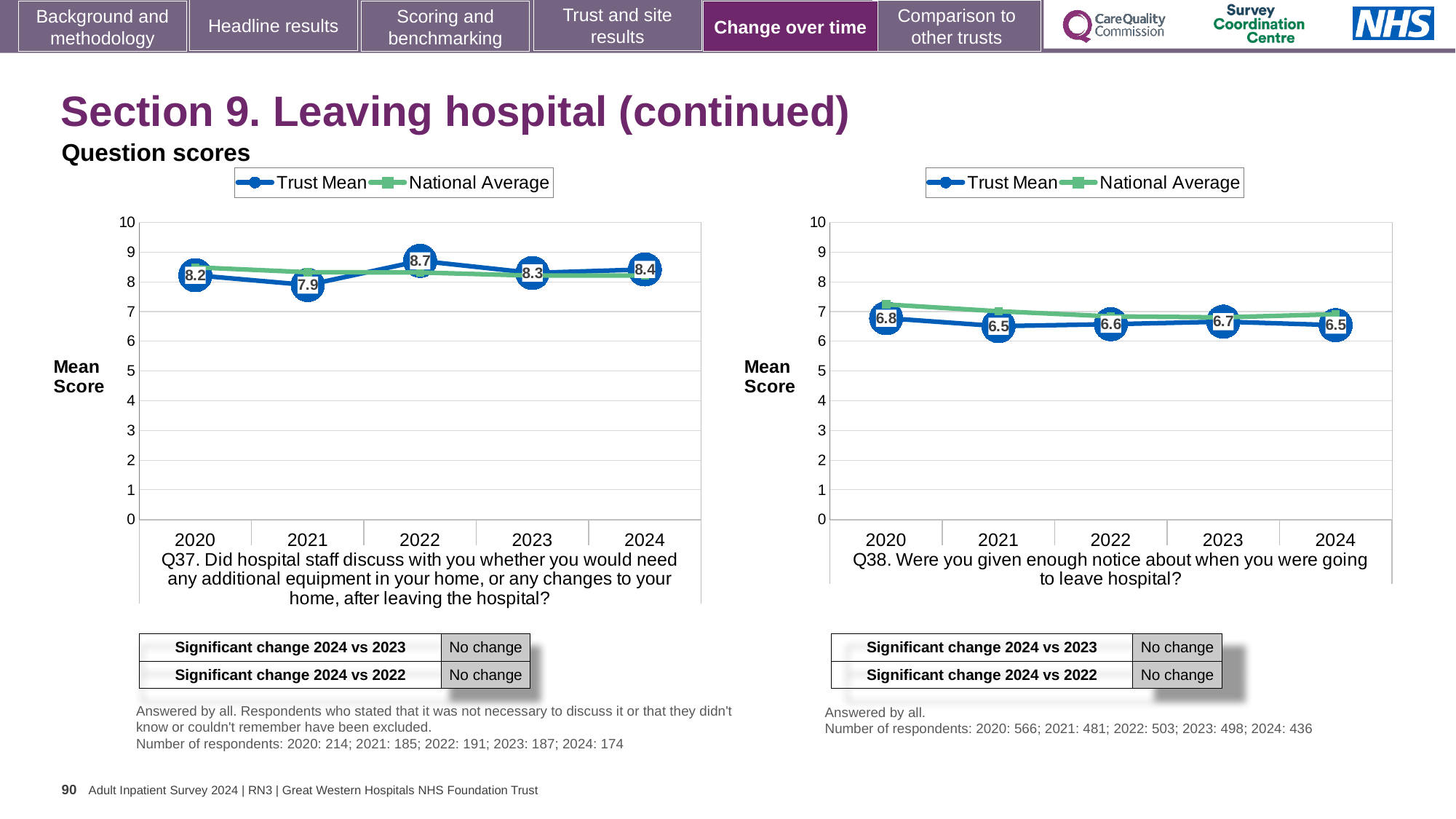
What kind of chart is the Q38 chart (right)? Line chart How many series does the legend of the Q37 chart (left) list? 2 On the Q38 chart (right), what is the Trust Mean score for 2020? 6.8 On the Q38 chart (right), which year has the highest Trust Mean score? 2020 On the Q37 chart (left), which year has the highest Trust Mean score? 2022 On the Q38 chart (right), how many years are plotted on the x axis? 5 On the Q37 chart (left), what is the Trust Mean score for 2021? 7.9 On the Q37 chart (left), which year has the lowest Trust Mean score? 2021 On the Q38 chart (right), what is the Trust Mean score for 2023? 6.7 On the Q37 chart (left), what is the Trust Mean score for 2022? 8.7 On the Q38 chart (right), is the Trust Mean score for 2024 greater or less than 7? less On the Q37 chart (left), what is the difference between the Trust Mean scores for 2022 and 2021? 0.8